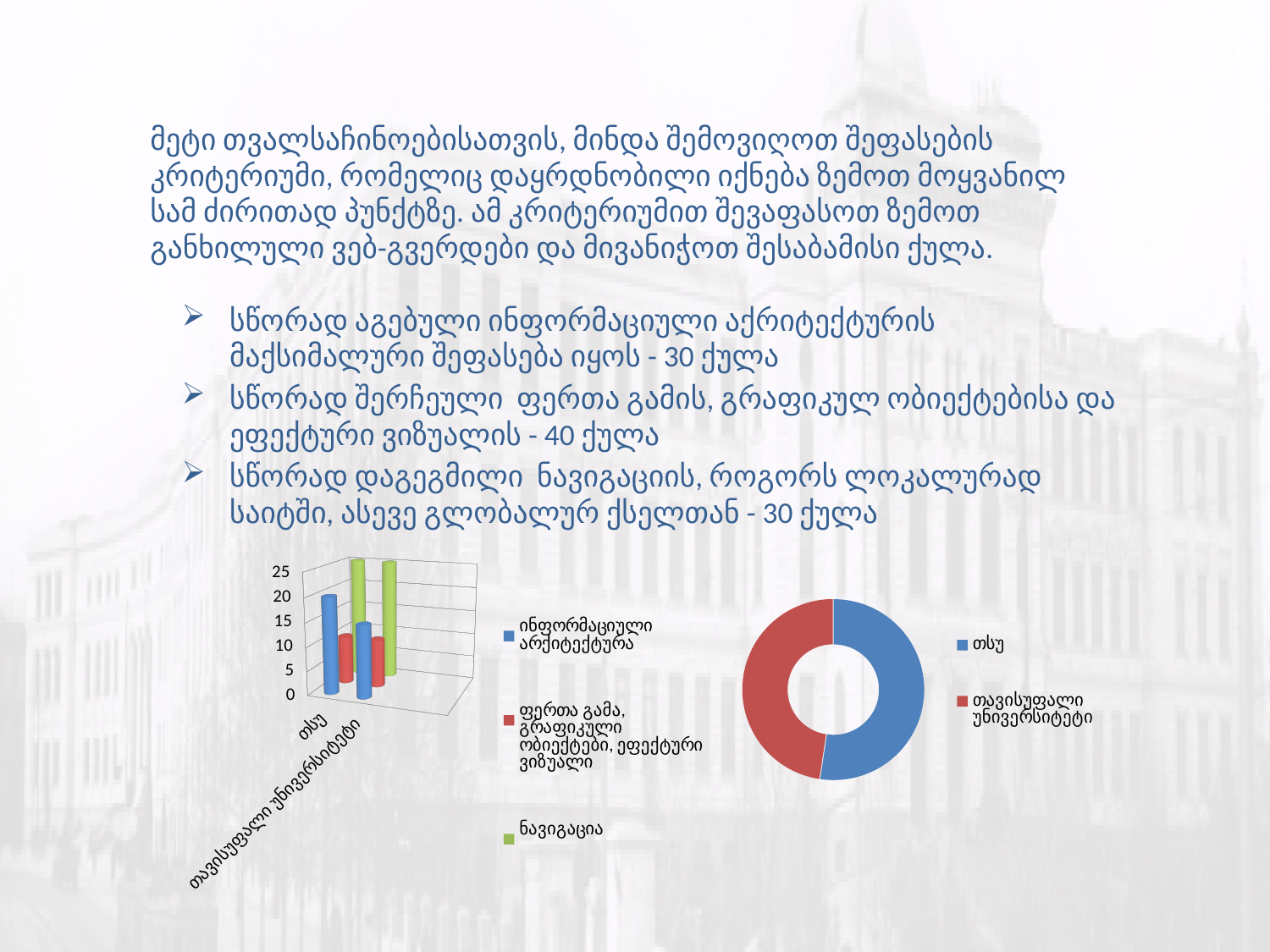
In the bar chart on the left, how many series does the legend list? 3 In the bar chart on the left, how many categories are shown on the x axis? 2 In the bar chart on the left, which series has the highest value for თსუ? ნავიგაცია In the doughnut chart on the right, what colour represents თსუ? blue In the bar chart on the left, is the value of ფერთა გამა, გრაფიკული ობიექტები, ეფექტური ვიზუალი for თსუ greater or less than 15? less What kind of chart is the chart on the right of the slide? doughnut chart In the bar chart on the left, is the value of ნავიგაცია for თსუ greater or less than 20? greater In the doughnut chart on the right, how many entries does the legend list? 2 In the bar chart on the left, what colour represents the ნავიგაცია series? green What kind of chart is the chart on the left of the slide? bar chart In the bar chart on the left, which series has the lowest value for თსუ? ფერთა გამა, გრაფიკული ობიექტები, ეფექტური ვიზუალი In the bar chart on the left, is the value of ინფორმაციული არქიტექტურა for თსუ greater or less than 15? greater